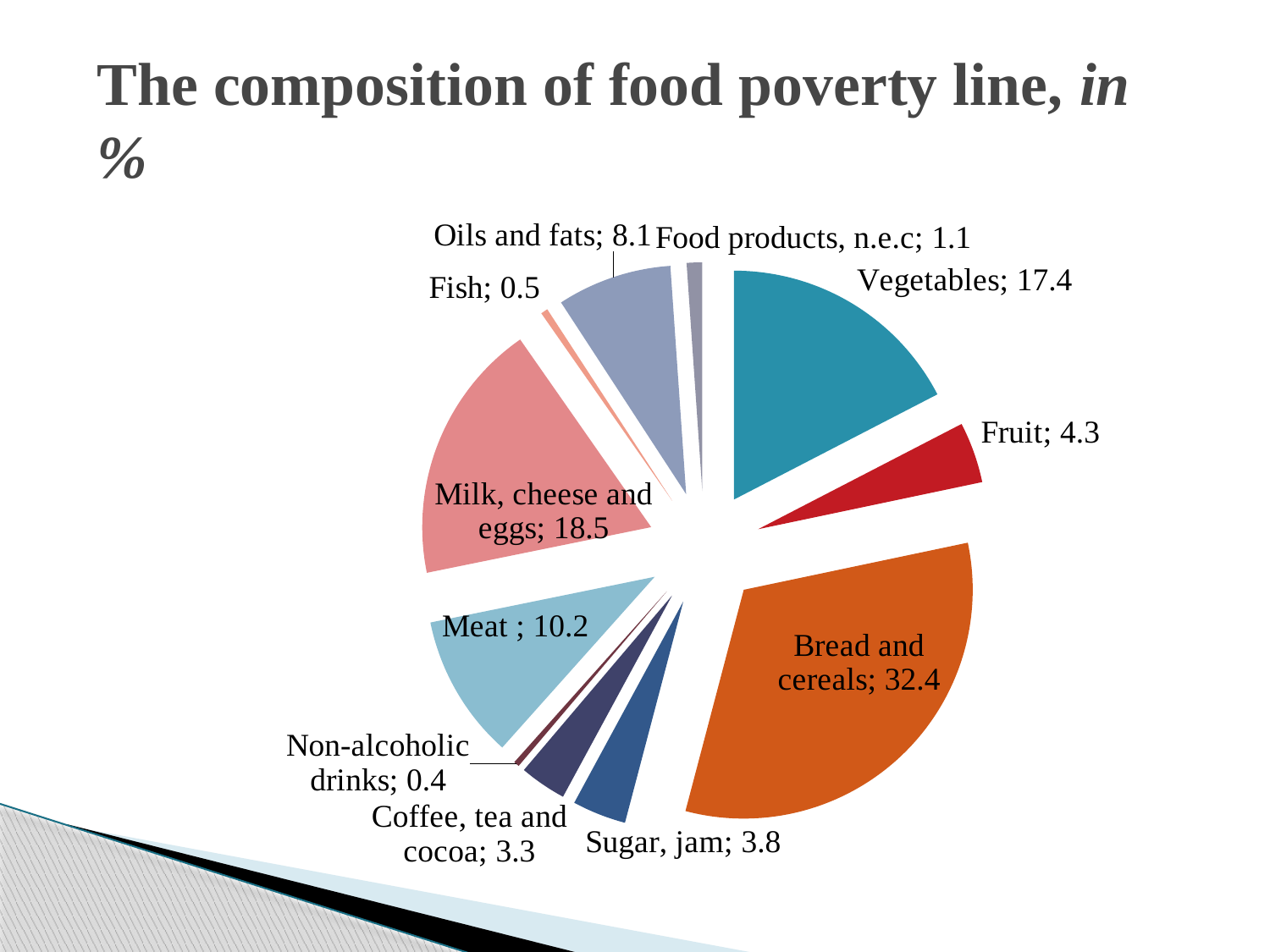
What is the difference between the values for Milk, cheese and eggs and Meat? 8.3 Which is larger, the value for Fruit or the value for Sugar, jam? Fruit What is the value for Oils and fats? 8.1 What is the value for Coffee, tea and cocoa? 3.3 What is the value for Bread and cereals? 32.4 What is the value for Milk, cheese and eggs? 18.5 Which category has the largest share of the pie? Bread and cereals How many categories are shown in the pie chart? 11 What is the title of the chart on the slide? The composition of food poverty line, in % What kind of chart is shown on the slide? Pie chart What is the difference between the values for Bread and cereals and Vegetables? 15 Which category has the smallest share of the pie? Non-alcoholic drinks